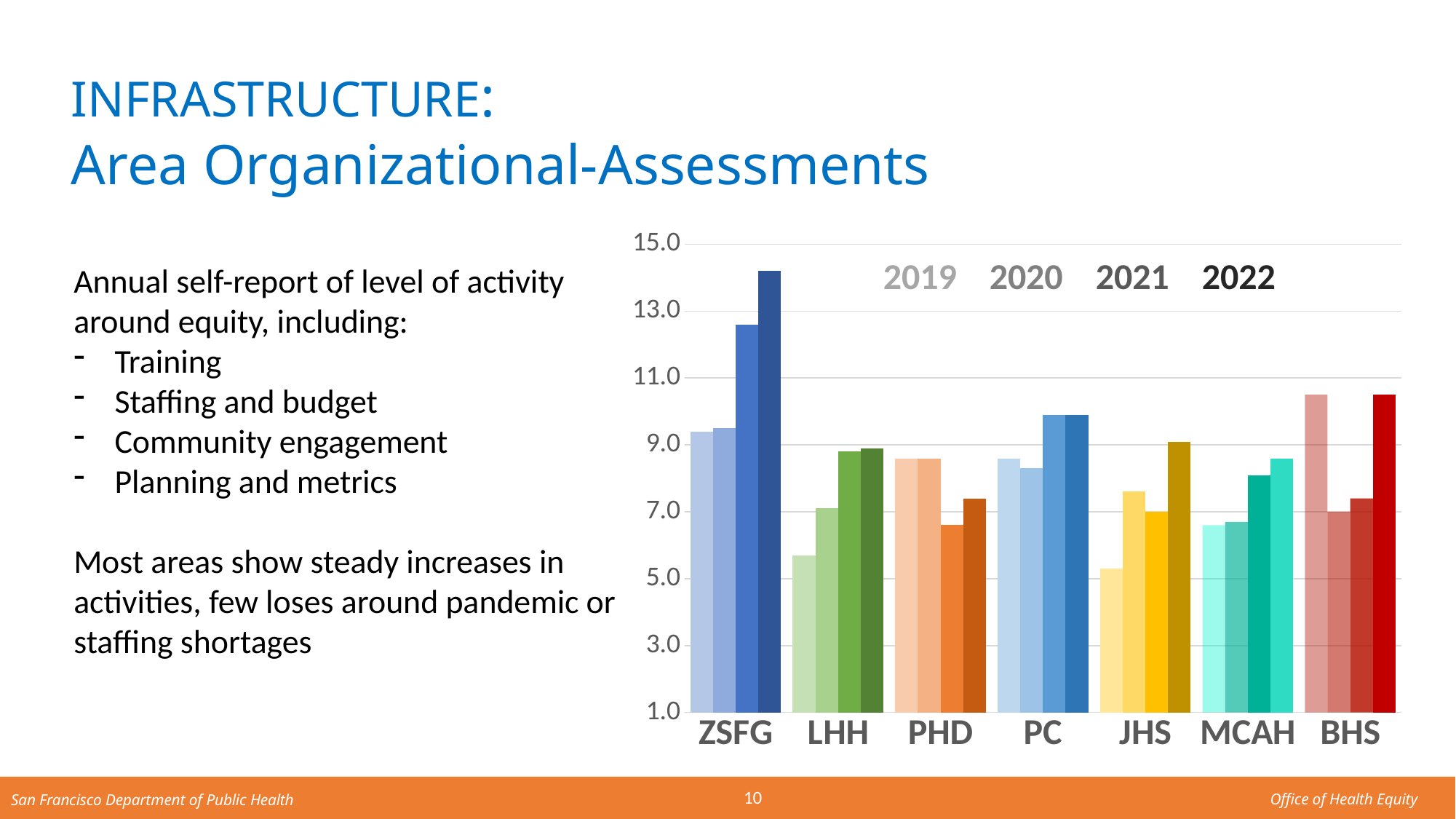
How many series (years) does the chart's legend list? 4 Do the values for ZSFG rise or fall from 2019 to 2022? rise Which category has the tallest bar in the chart? ZSFG Which is larger for LHH, the 2019 value or the 2022 value? 2022 What kind of chart is shown on the slide? bar chart Is the 2022 value for PC greater or less than 9.0? greater How many categories are shown along the x axis of the chart? 7 Is the 2019 value for LHH greater or less than 7.0? less Is the 2021 value for PHD greater or less than 7.0? less Which year's bar is the tallest for ZSFG? 2022